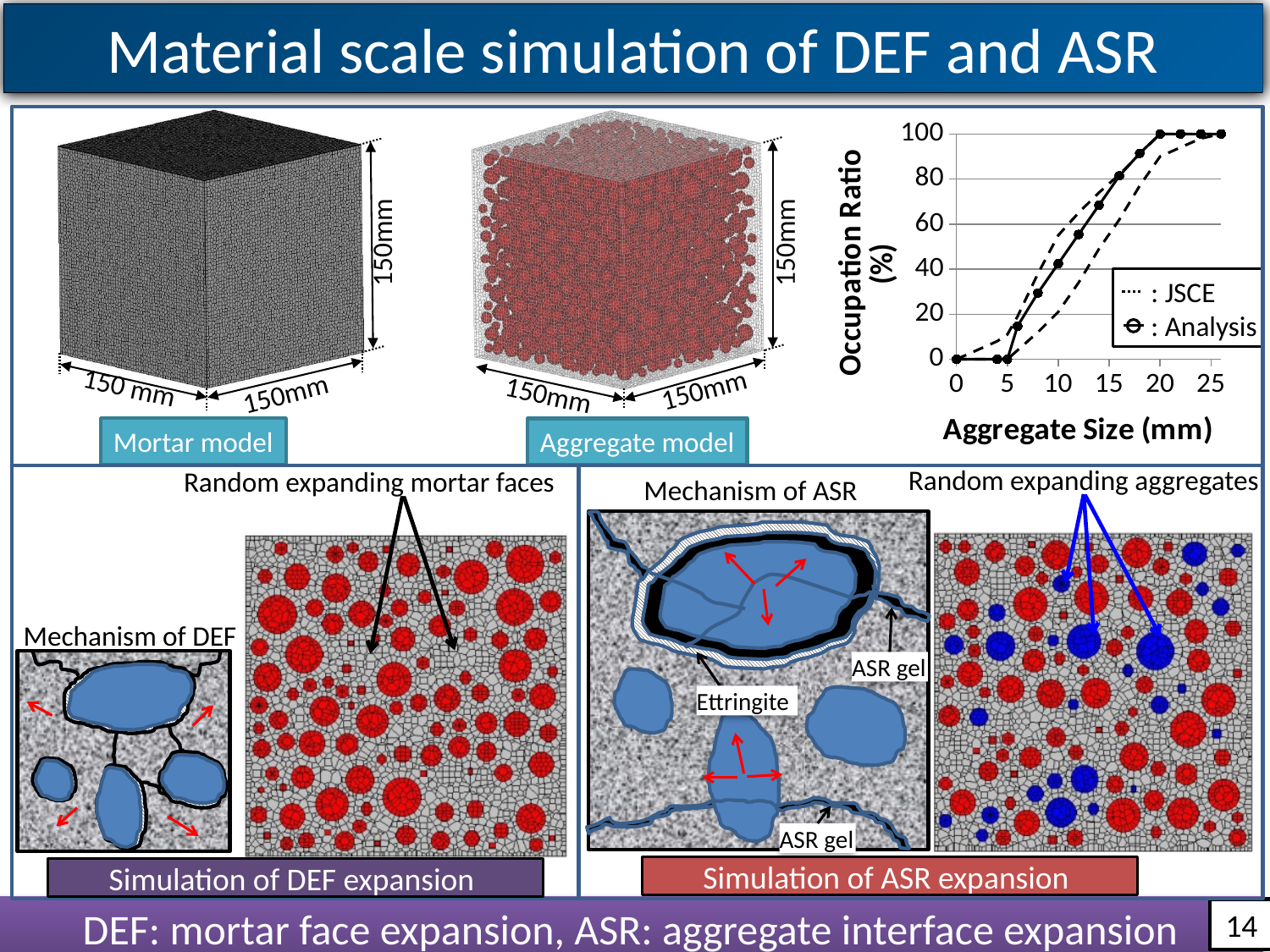
In the Occupation Ratio chart, is the Analysis value at an aggregate size of 8 mm greater or less than 40? less In the Occupation Ratio chart, is the Analysis value at an aggregate size of 10 mm greater or less than 20? greater What is the highest value shown on the y axis of the Occupation Ratio chart? 100 In the Occupation Ratio chart, is the Analysis value at an aggregate size of 4 mm greater or less than 20? less What kind of chart is shown in the top-right of the slide? line chart What are the two series named in the legend of the Occupation Ratio chart? JSCE and Analysis In the Occupation Ratio chart, does the Analysis series rise or fall as aggregate size increases? rise How many series does the legend of the Occupation Ratio chart list? 2 What is the label of the x axis of the Occupation Ratio chart? Aggregate Size (mm)